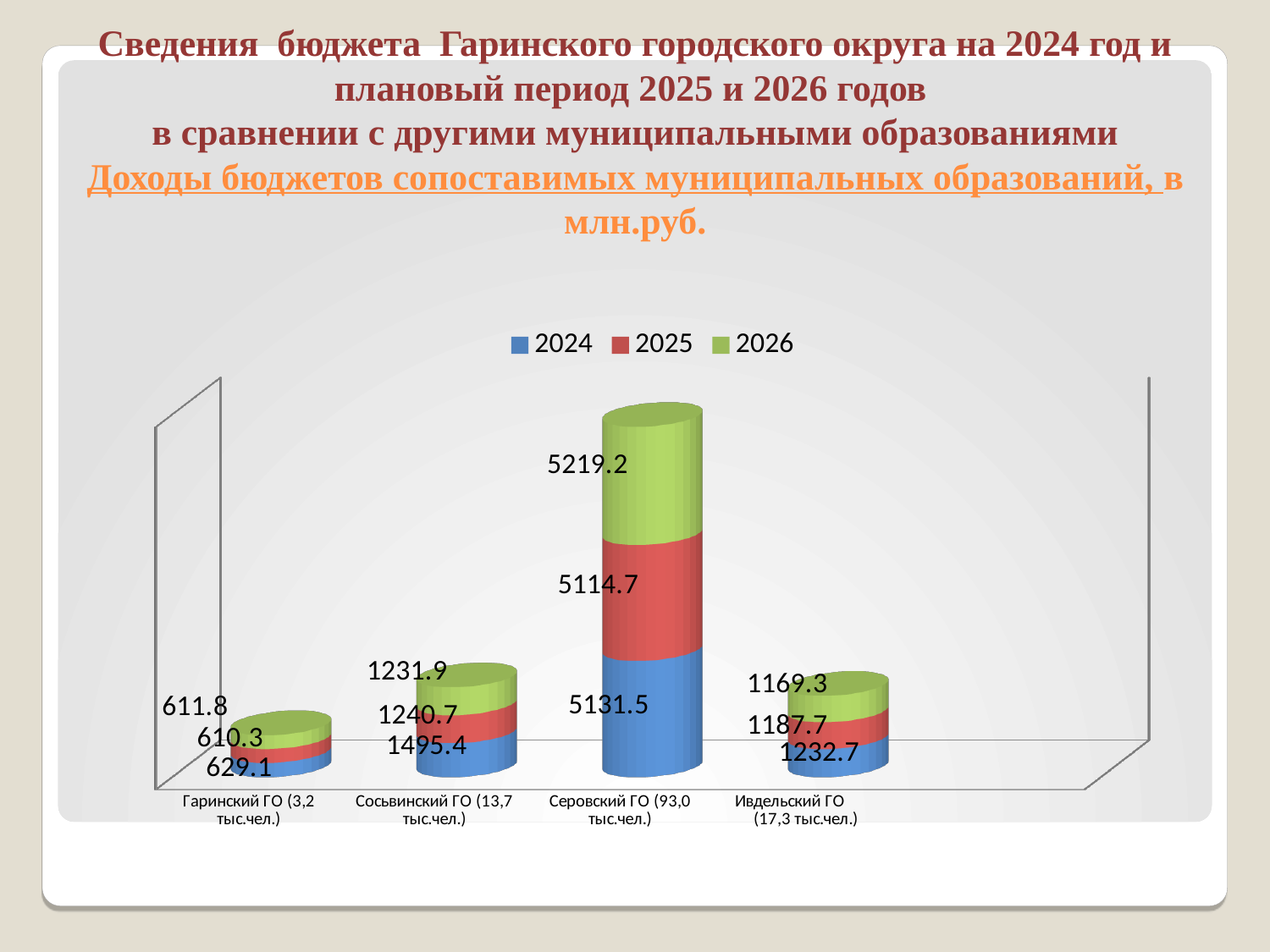
What is the difference between the 2024 values for Сосьвинский ГО and Ивдельский ГО? 262.7 Which municipality has the lowest 2024 value? Гаринский ГО What kind of chart is shown on the slide? Stacked bar chart What is the total of the stacked bar for Гаринский ГО? 1851.2 Which is larger: the 2025 value for Сосьвинский ГО or the 2025 value for Ивдельский ГО? Сосьвинский ГО What is the 2024 value for Сосьвинский ГО? 1495.4 Which municipality has the highest 2026 value? Серовский ГО What is the 2024 value for Серовский ГО? 5131.5 How many municipalities are shown on the x axis? 4 What is the 2026 value for Гаринский ГО? 611.8 What is the 2025 value for Ивдельский ГО? 1187.7 How many series does the legend list? 3